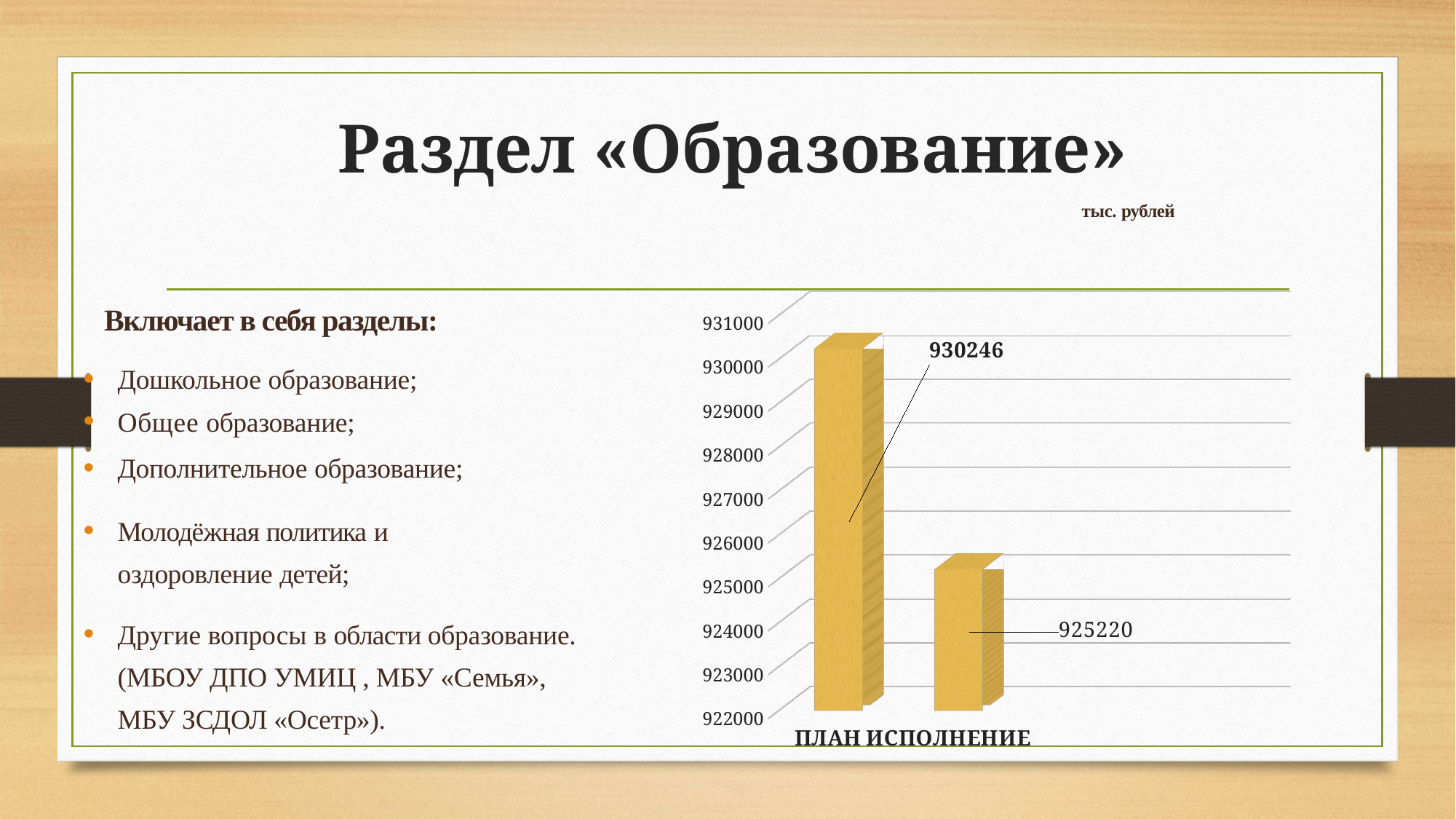
Which is larger, the value for ПЛАН or the value for ИСПОЛНЕНИЕ? ПЛАН How many bars are shown in the chart? 2 Is the value for ИСПОЛНЕНИЕ greater or less than 926000? less Which category has the lowest value? ИСПОЛНЕНИЕ What unit is indicated for the chart values? тыс. рублей What is the value for ИСПОЛНЕНИЕ? 925220 Is the value for ПЛАН greater or less than 929000? greater Do the values rise or fall from ПЛАН to ИСПОЛНЕНИЕ? fall What is the value for ПЛАН? 930246 Which category has the highest value? ПЛАН What is the difference between the values for ПЛАН and ИСПОЛНЕНИЕ? 5026 What kind of chart is shown on the slide? bar chart